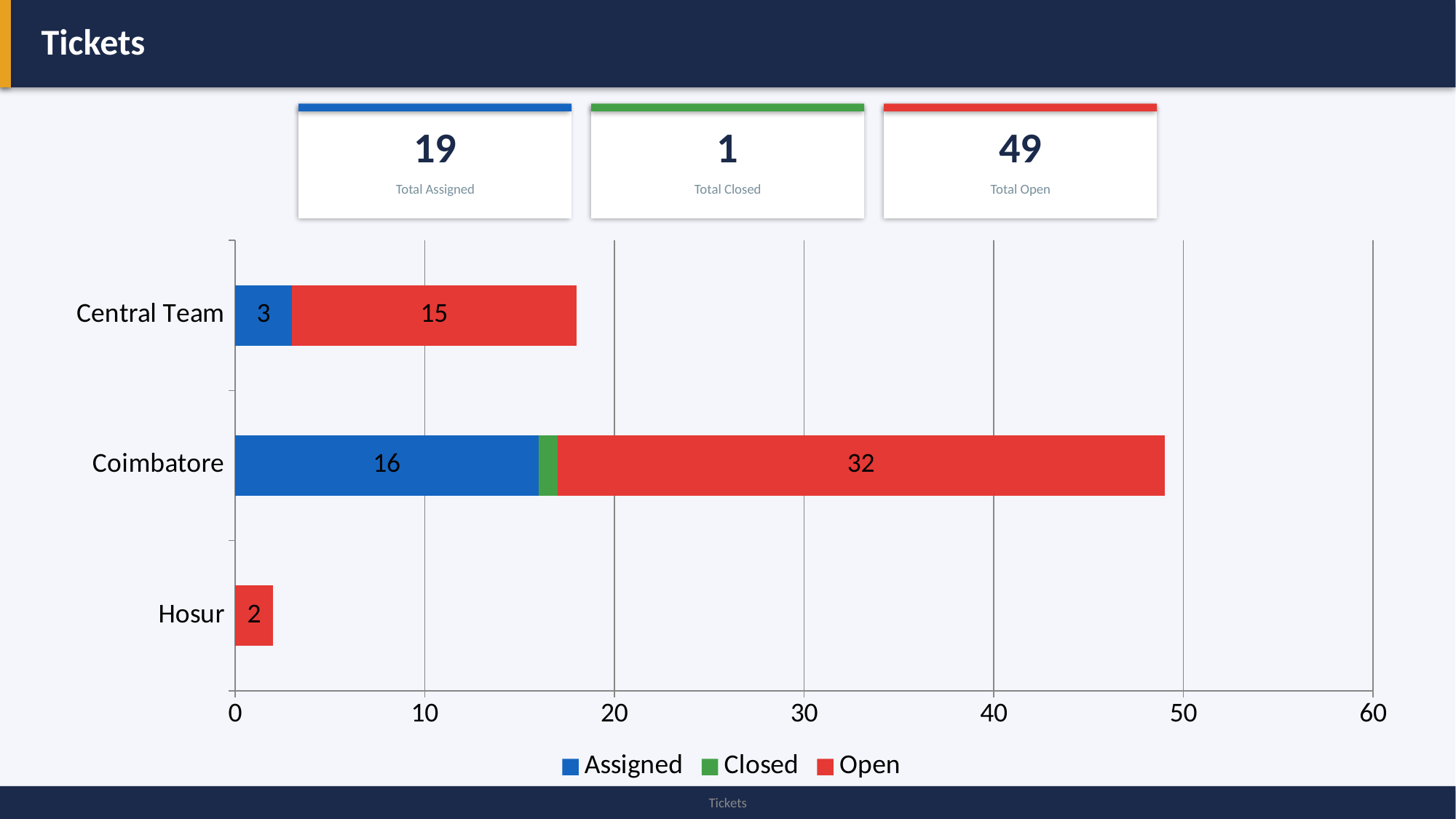
How many categories are shown on the chart? 3 What is the difference between the Open values for Coimbatore and Central Team? 17 How many series does the chart legend list? 3 What is the total of the stacked bar for Central Team? 18 What is the Assigned value for Central Team? 3 What is the Open value for Coimbatore? 32 Which category has the lowest Open value? Hosur Which is larger, the Assigned value for Coimbatore or the Open value for Central Team? Assigned value for Coimbatore What is the Open value for Hosur? 2 Is the total length of the Coimbatore bar greater or less than 40? greater Which category has the highest Assigned value? Coimbatore What type of chart is shown on the slide? bar chart